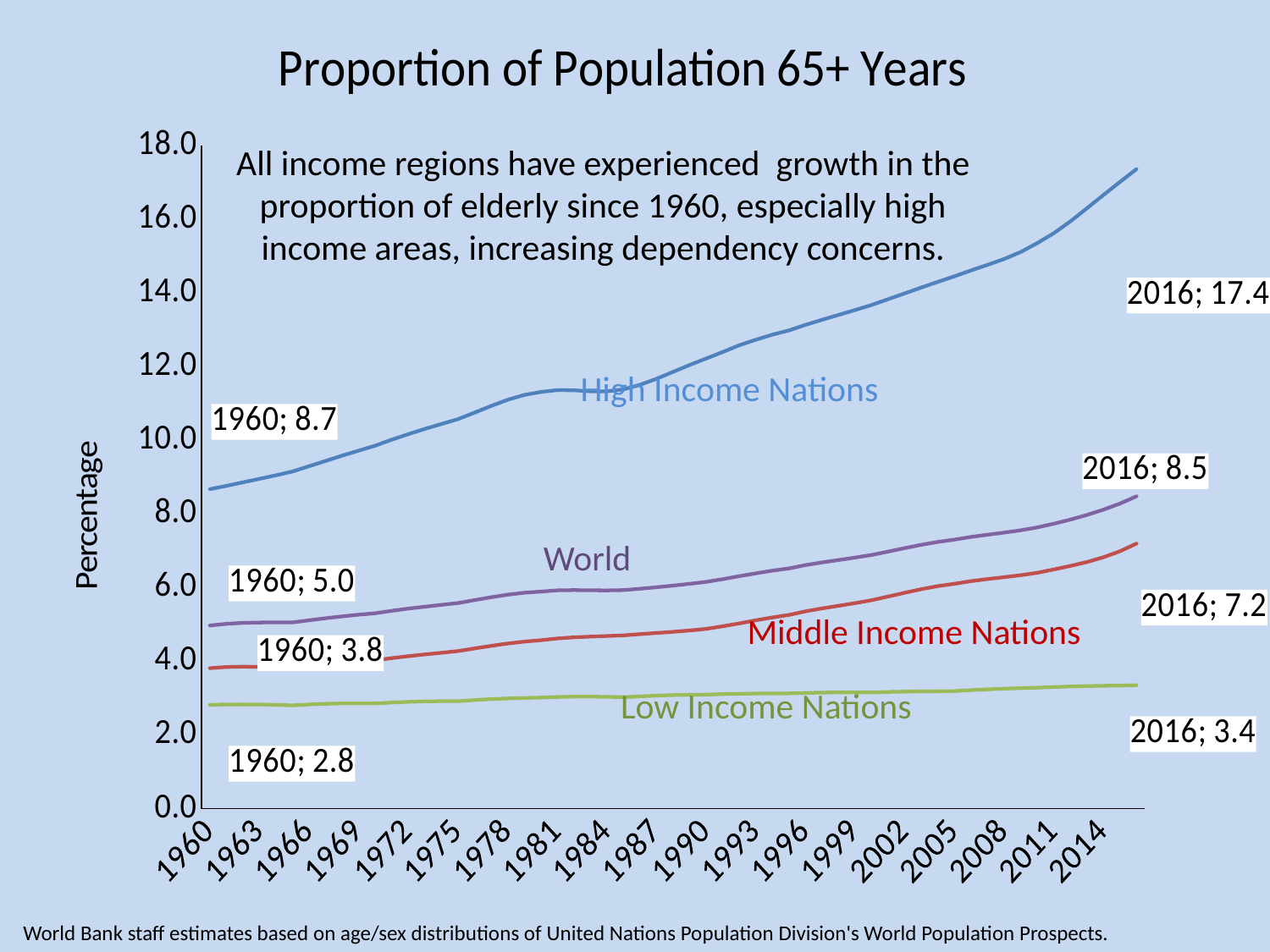
Does the Low Income Nations line rise or fall from 1960 to 2016? rise What type of chart is shown on the slide? line chart How many series are plotted on the chart? 4 What was the proportion of population 65+ years for High Income Nations in 1960? 8.7 What was the proportion of population 65+ years for Low Income Nations in 2016? 3.4 Which series had the highest proportion of population 65+ years in 2016? High Income Nations What was the proportion of population 65+ years for High Income Nations in 2016? 17.4 What was the proportion of population 65+ years for Middle Income Nations in 2016? 7.2 What is the difference between the World and Middle Income Nations values in 2016? 1.3 By how much did the High Income Nations proportion of population 65+ years increase from 1960 to 2016? 8.7 What was the World proportion of population 65+ years in 1960? 5.0 Which series had the lowest proportion of population 65+ years in 1960? Low Income Nations